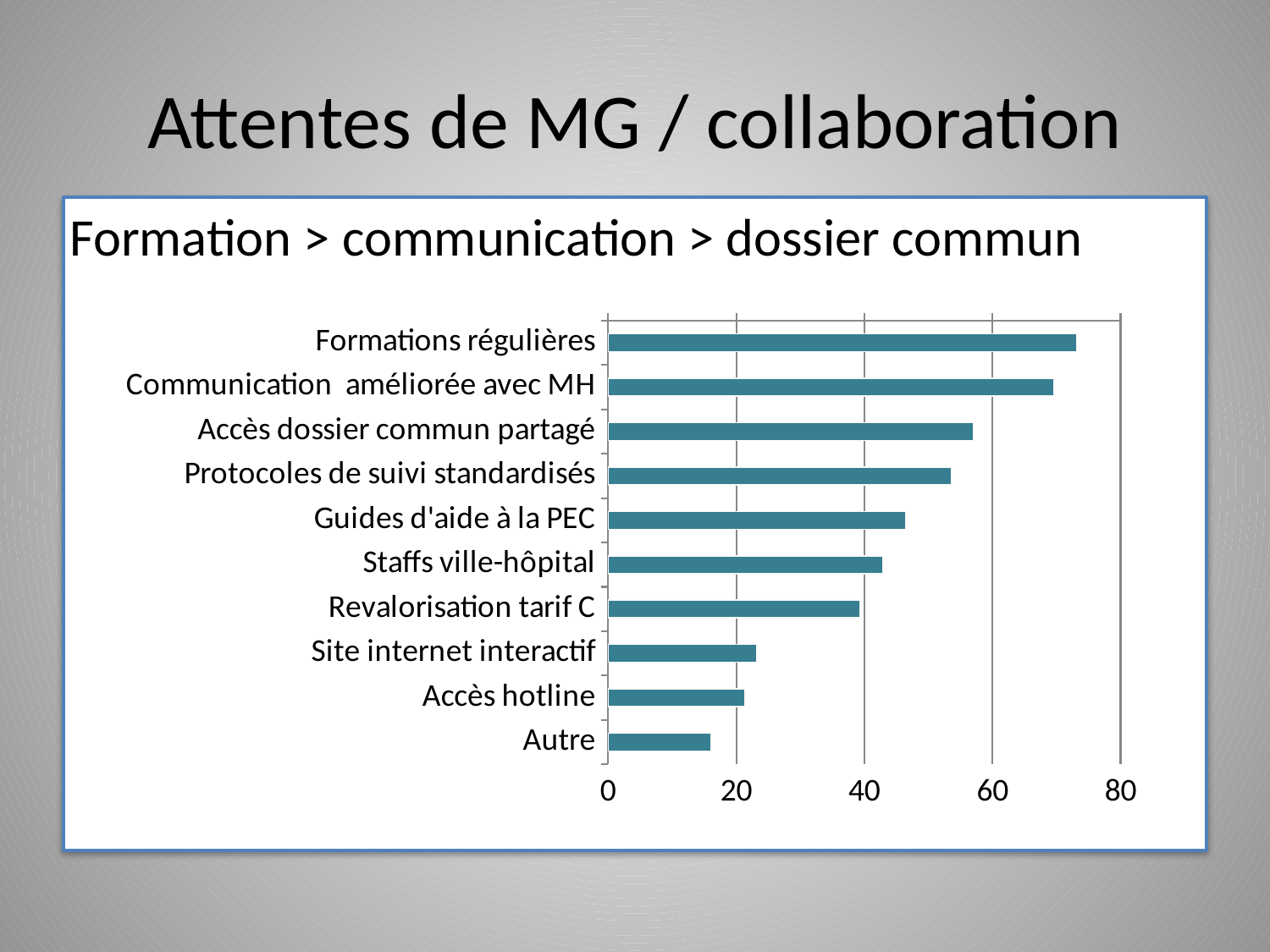
Is the value for Protocoles de suivi standardisés greater or less than 60? less Which is larger, the value for Revalorisation tarif C or the value for Accès hotline? Revalorisation tarif C What is the highest value shown on the horizontal axis of the chart? 80 What kind of chart is shown on the slide? Bar chart Which is larger, the value for Accès dossier commun partagé or the value for Site internet interactif? Accès dossier commun partagé Which category has the longest bar in the chart? Formations régulières Is the value for Guides d'aide à la PEC greater or less than 40? greater Is the value for Communication améliorée avec MH greater or less than 60? greater Which category has the shortest bar in the chart? Autre How many categories are shown in the bar chart? 10